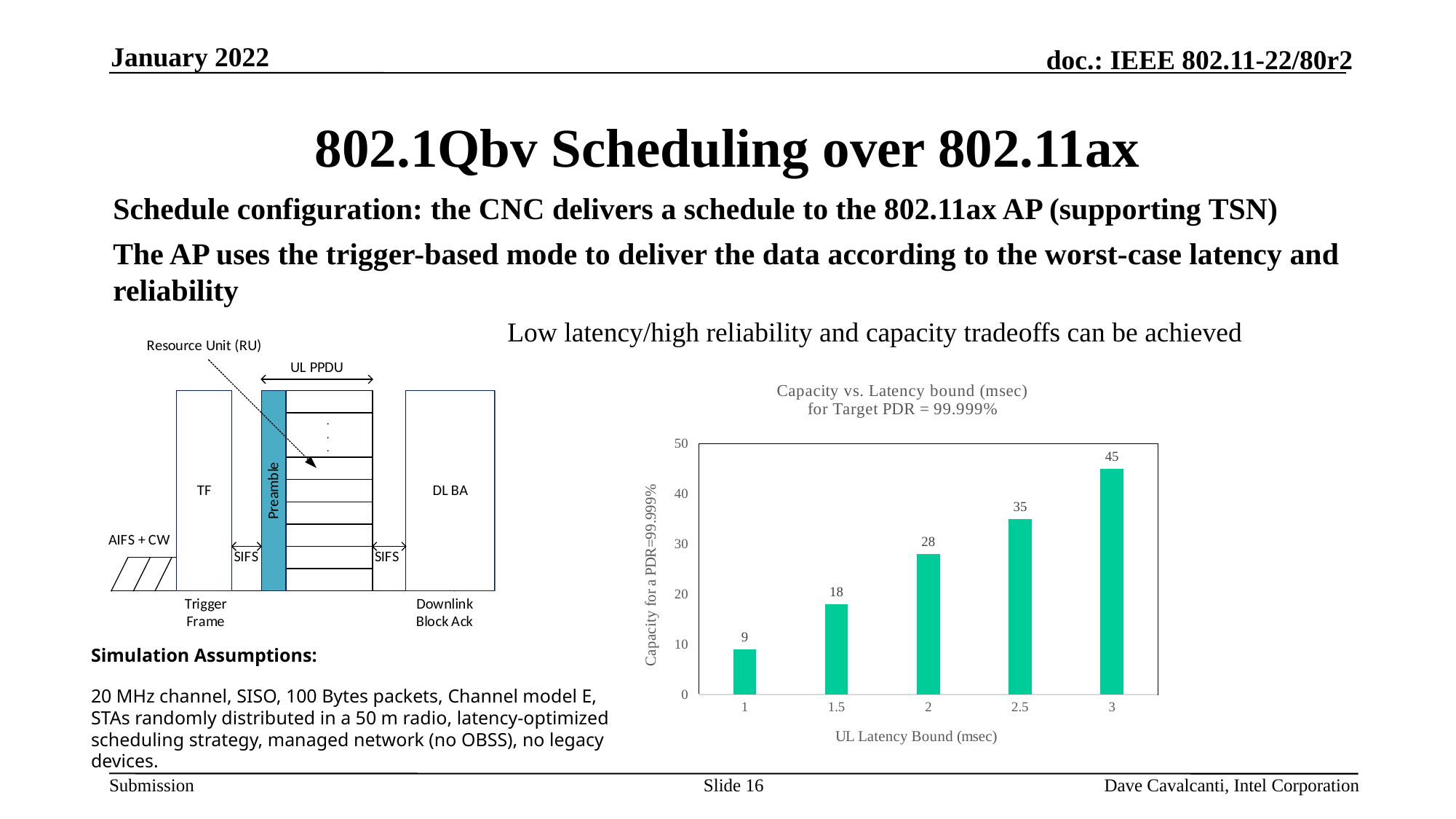
What is the capacity value for a UL latency bound of 1 msec? 9 Does capacity rise or fall as the UL latency bound increases? Rise What is the capacity value for a UL latency bound of 2 msec? 28 What kind of chart is shown on the slide? Bar chart Which UL latency bound has the highest capacity? 3 How many latency bound categories are shown in the chart? 5 What is the title of the chart? Capacity vs. Latency bound (msec) for Target PDR = 99.999% What is the difference in capacity between the 2 msec and 1.5 msec latency bounds? 10 What is the difference in capacity between the 3 msec and 1 msec latency bounds? 36 Which has a larger capacity: the 1.5 msec or the 2.5 msec latency bound? 2.5 msec What is the capacity value for a UL latency bound of 2.5 msec? 35 Which UL latency bound has the lowest capacity? 1